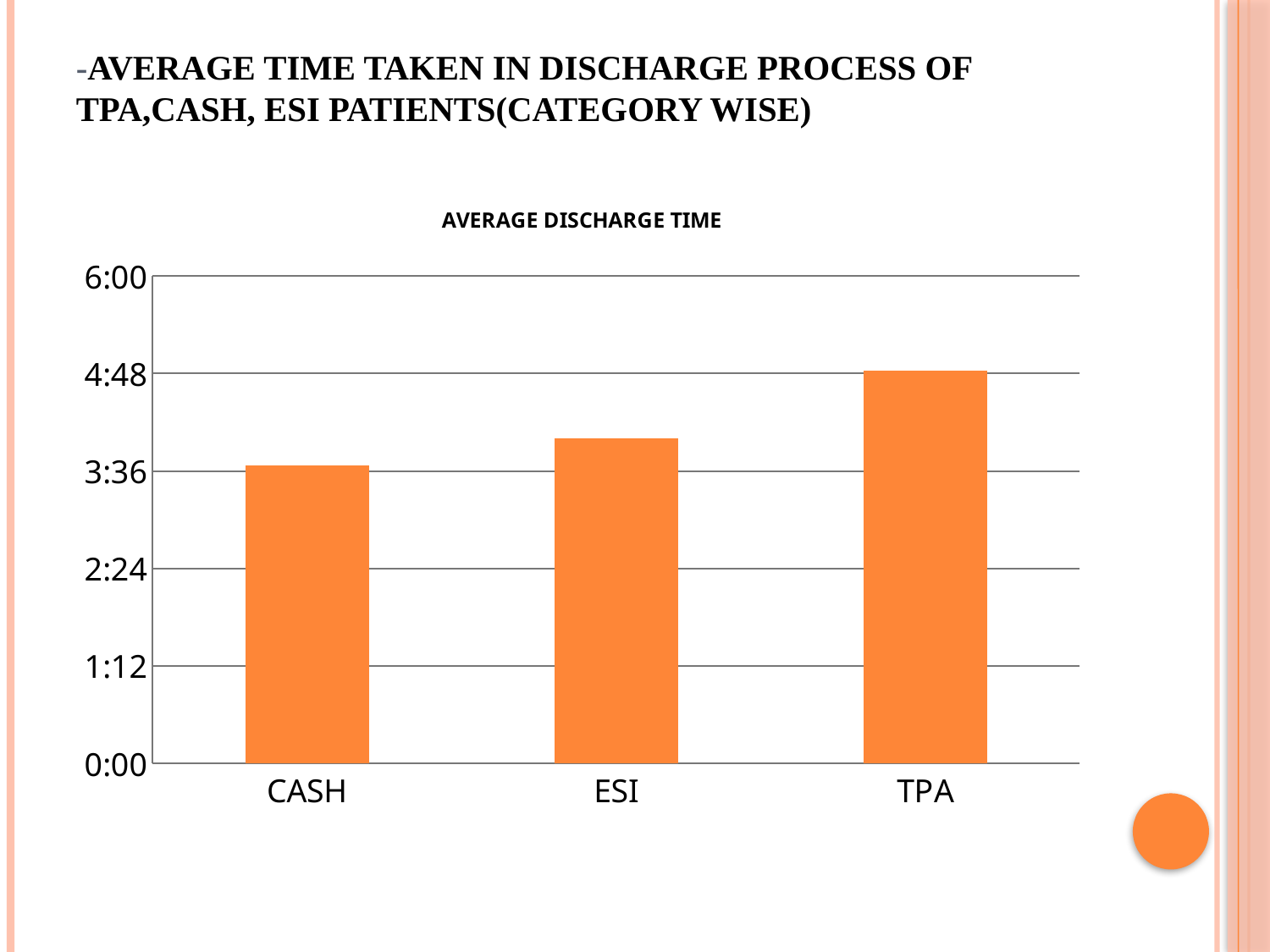
What is the title of the chart? AVERAGE DISCHARGE TIME What kind of chart is shown on the slide? bar chart Do the bar values rise or fall from left to right across CASH, ESI and TPA? rise Which category has the lowest average discharge time? CASH Is the value for ESI greater or less than 4:48? less Is the value for CASH greater or less than 2:24? greater Is the value for TPA greater or less than 3:36? greater How many categories are shown on the x axis of the chart? 3 Which has a higher average discharge time, TPA or ESI? TPA Which category has the highest average discharge time? TPA Which has a higher average discharge time, ESI or CASH? ESI Which has a higher average discharge time, TPA or CASH? TPA